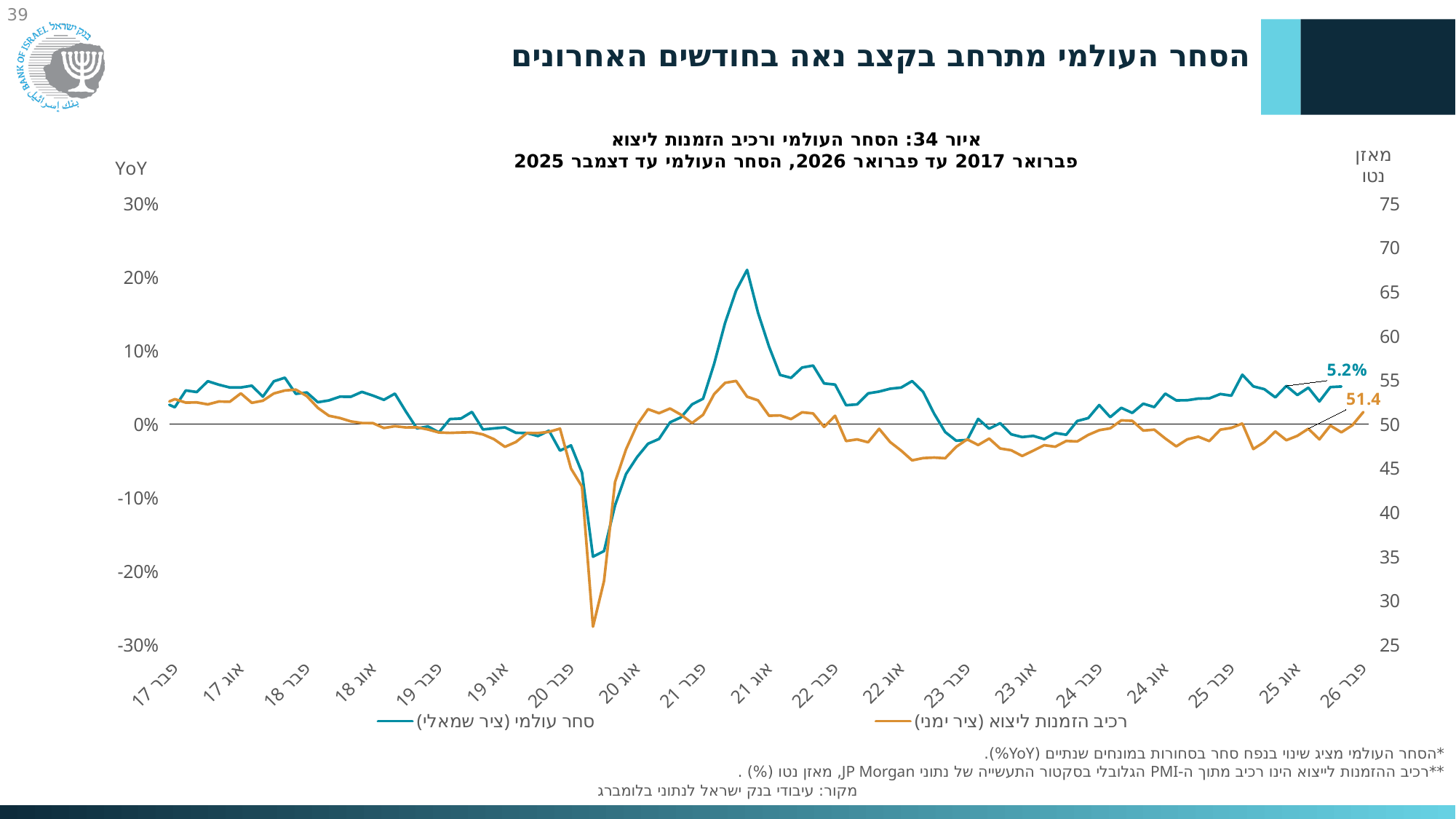
How many series does the legend list? 2 What kind of chart is shown on the slide? Line chart What is the latest value shown for the export orders component series (רכיב הזמנות ליצוא) at the end of the chart? 51.4 Is the lowest value of the world trade series (blue line) in 2020 greater or less than -10%? less Does the world trade series (blue line) rise or fall between אוג 22 and פבר 23? fall Is the peak value of the world trade series (blue line) around אוג 21 greater or less than 10%? greater Does the export orders component series (orange line) rise or fall between פבר 25 and פבר 26? rise Is the lowest value of the export orders component series (orange line) around 2020 greater or less than 30 on the right axis? less What is the latest value shown for the world trade series (סחר עולמי) at the end of the chart? 5.2% What is the label of the right-hand vertical axis? מאזן נטו What is the figure number given in the chart title? איור 34